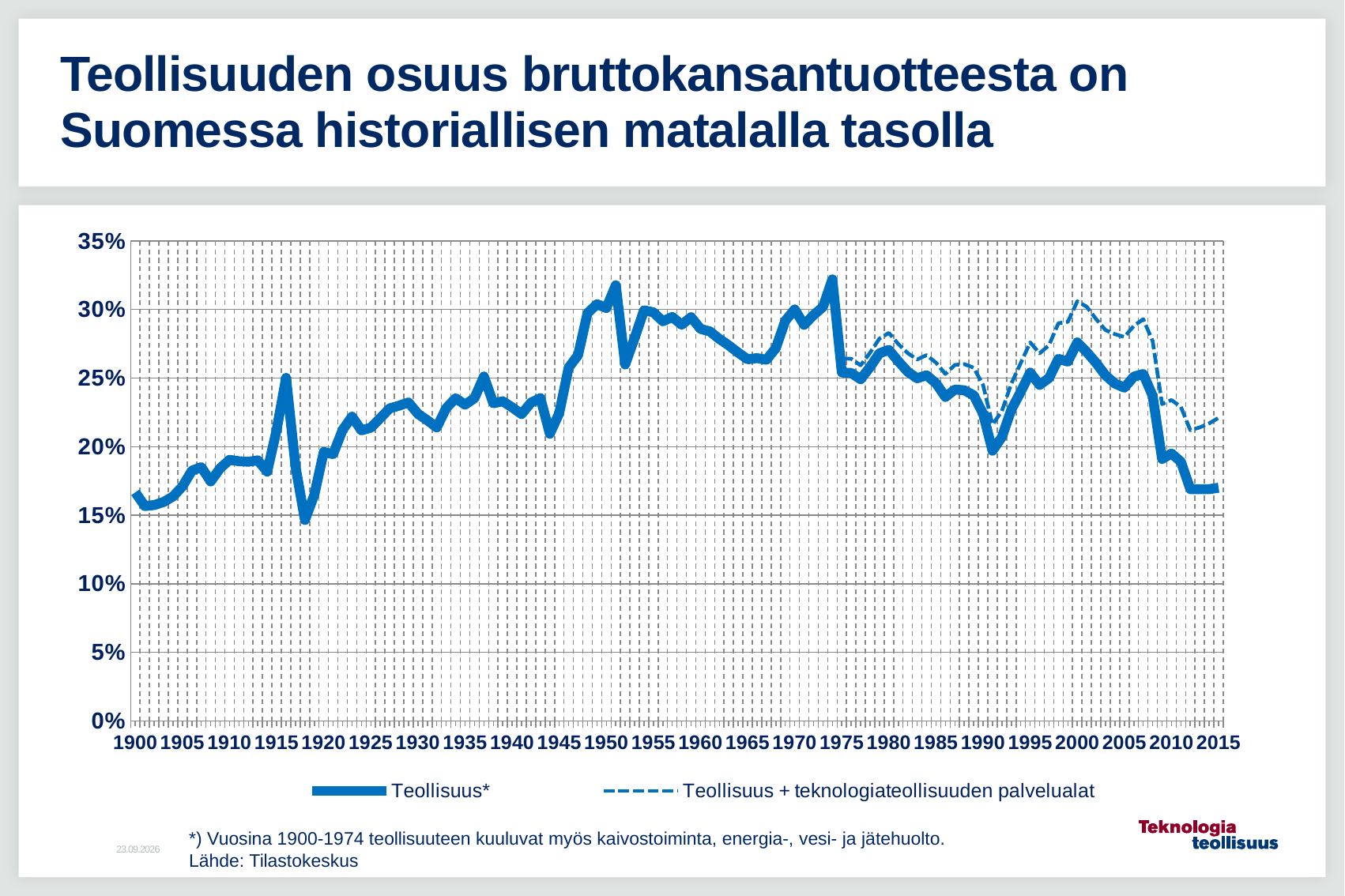
Is the value for Teollisuus* in 1974 greater or less than 30%? greater Is the value for Teollisuus* in 1918 greater or less than 20%? less Is the value for Teollisuus* in 2015 greater or less than 20%? less Does the Teollisuus* line rise or fall between 2007 and 2012? fall What kind of chart is shown on the slide? line chart In 2000, which series has the higher value, Teollisuus* or Teollisuus + teknologiateollisuuden palvelualat? Teollisuus + teknologiateollisuuden palvelualat Which is larger, the Teollisuus* value in 1974 or in 2015? 1974 Which series is drawn with a dashed line? Teollisuus + teknologiateollisuuden palvelualat How many series does the legend list? 2 What is the source given for the chart data? Tilastokeskus